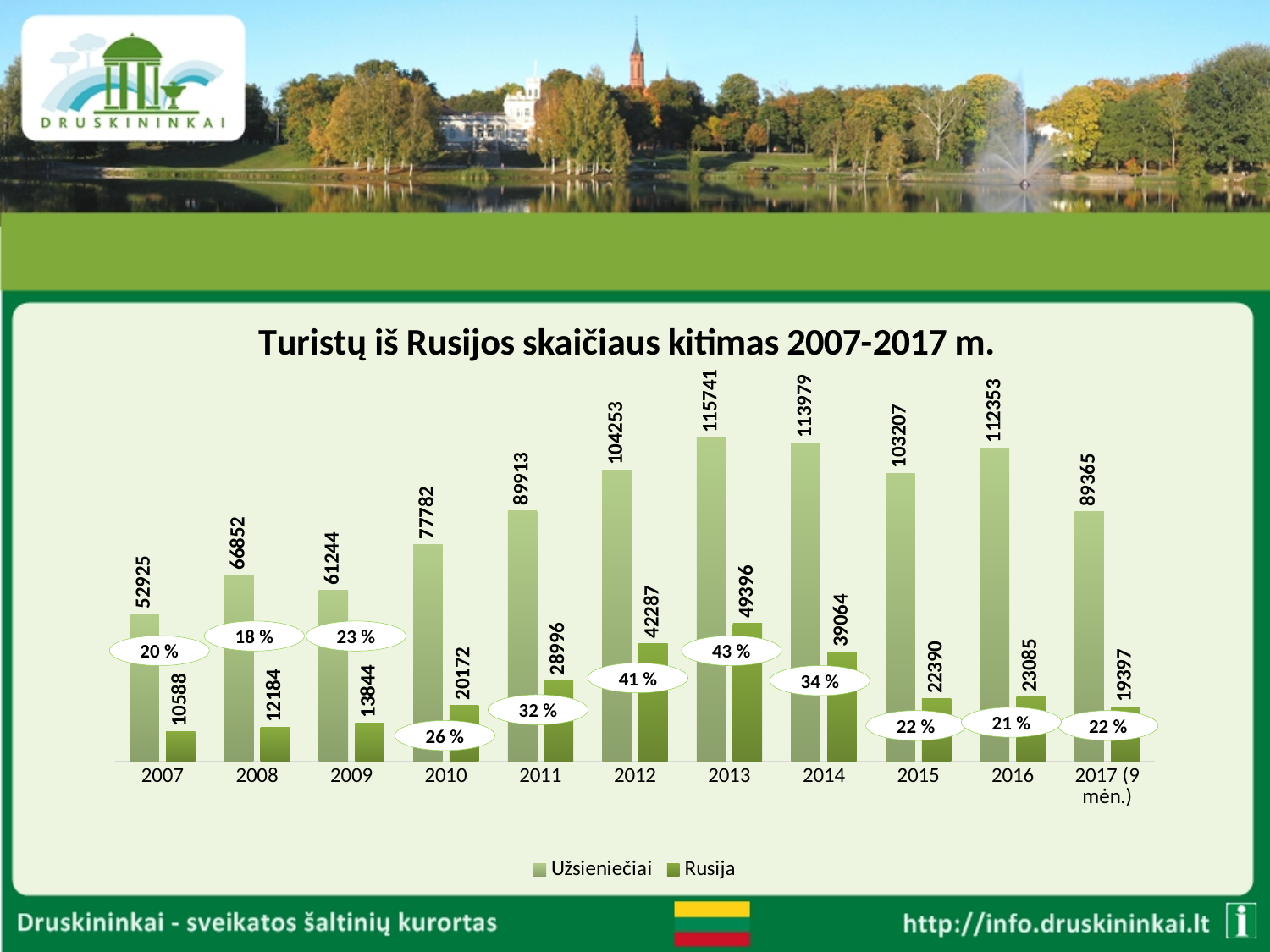
Which year has the lowest value for Užsieniečiai? 2007 How many series does the legend list? 2 What is the value for Užsieniečiai in 2013? 115741 Which is larger: the Rusija value in 2014 or in 2015? 2014 Does the Rusija value rise or fall from 2007 to 2013? rise What is the difference between the Užsieniečiai and Rusija values in 2012? 61966 Which year has the highest value for Rusija? 2013 What percentage is shown in the oval label for 2013? 43 % What kind of chart is shown on the slide? bar chart What is the value for Rusija in 2017 (9 mėn.)? 19397 How many years (categories) are shown on the x axis? 11 What is the value for Rusija in 2010? 20172